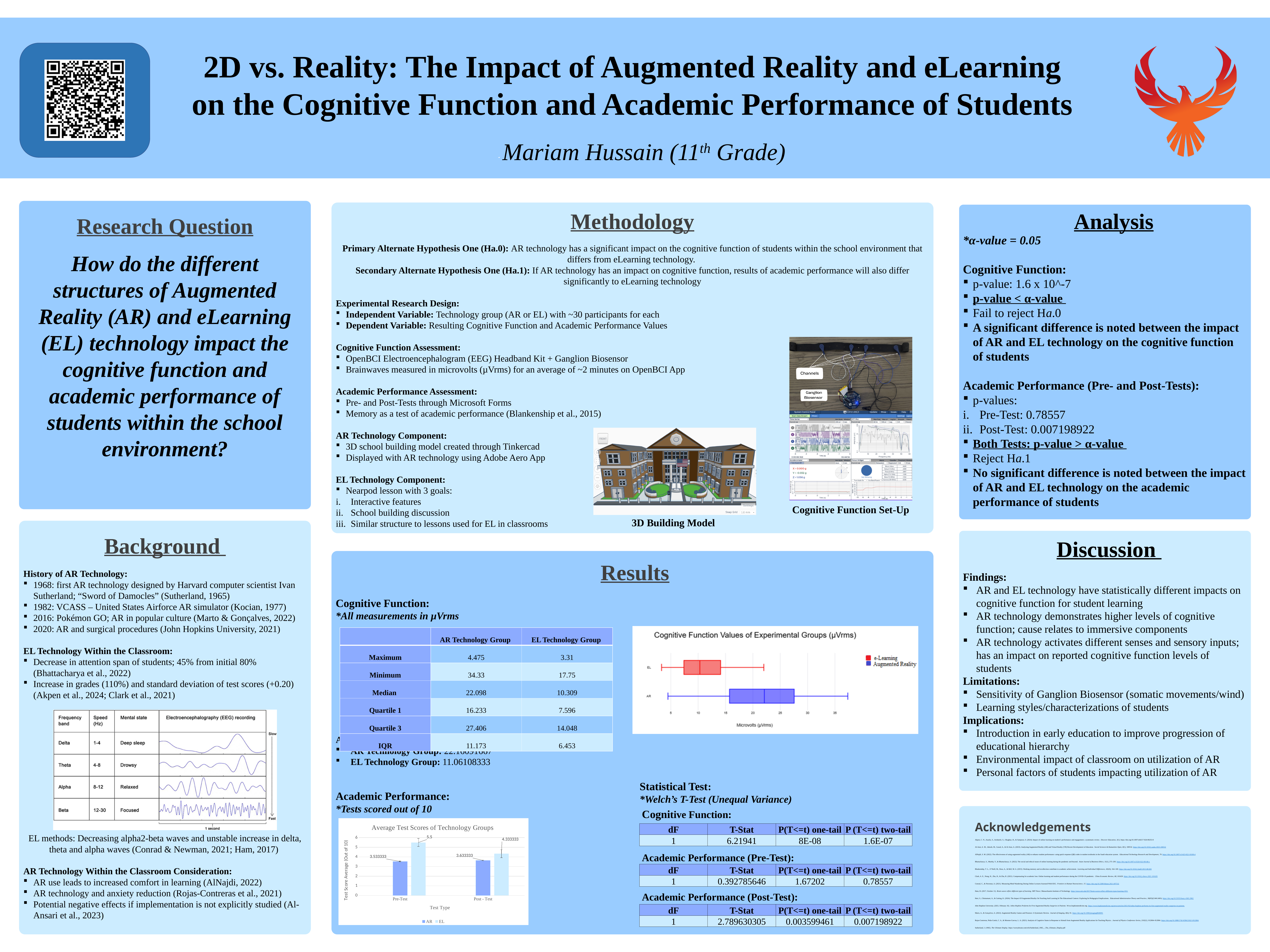
In the 'Average Test Scores of Technology Groups' chart, which test type has the highest EL value? Pre-Test In the 'Cognitive Function Values of Experimental Groups (µVrms)' chart, what are the two legend entries? e-Learning, Augmented Reality What kind of chart is 'Average Test Scores of Technology Groups'? bar chart In the 'Average Test Scores of Technology Groups' chart, what is the AR value for Post-Test? 3.633333 In the 'Average Test Scores of Technology Groups' chart, what is the AR value for Pre-Test? 3.533333 In the 'Average Test Scores of Technology Groups' chart, does the EL value fall or rise from Pre-Test to Post-Test? fall In the 'Average Test Scores of Technology Groups' chart, how many test types are shown on the x axis? 2 In the 'Average Test Scores of Technology Groups' chart, what is the EL value for Pre-Test? 5.5 In the 'Average Test Scores of Technology Groups' chart, which series has the higher value for Pre-Test, AR or EL? EL In the 'Average Test Scores of Technology Groups' chart, what is the EL value for Post-Test? 4.333333 In the 'Cognitive Function Values of Experimental Groups (µVrms)' chart, what is the x-axis label? Microvolts (µVrms) In the 'Average Test Scores of Technology Groups' chart, how many series does the legend list? 2